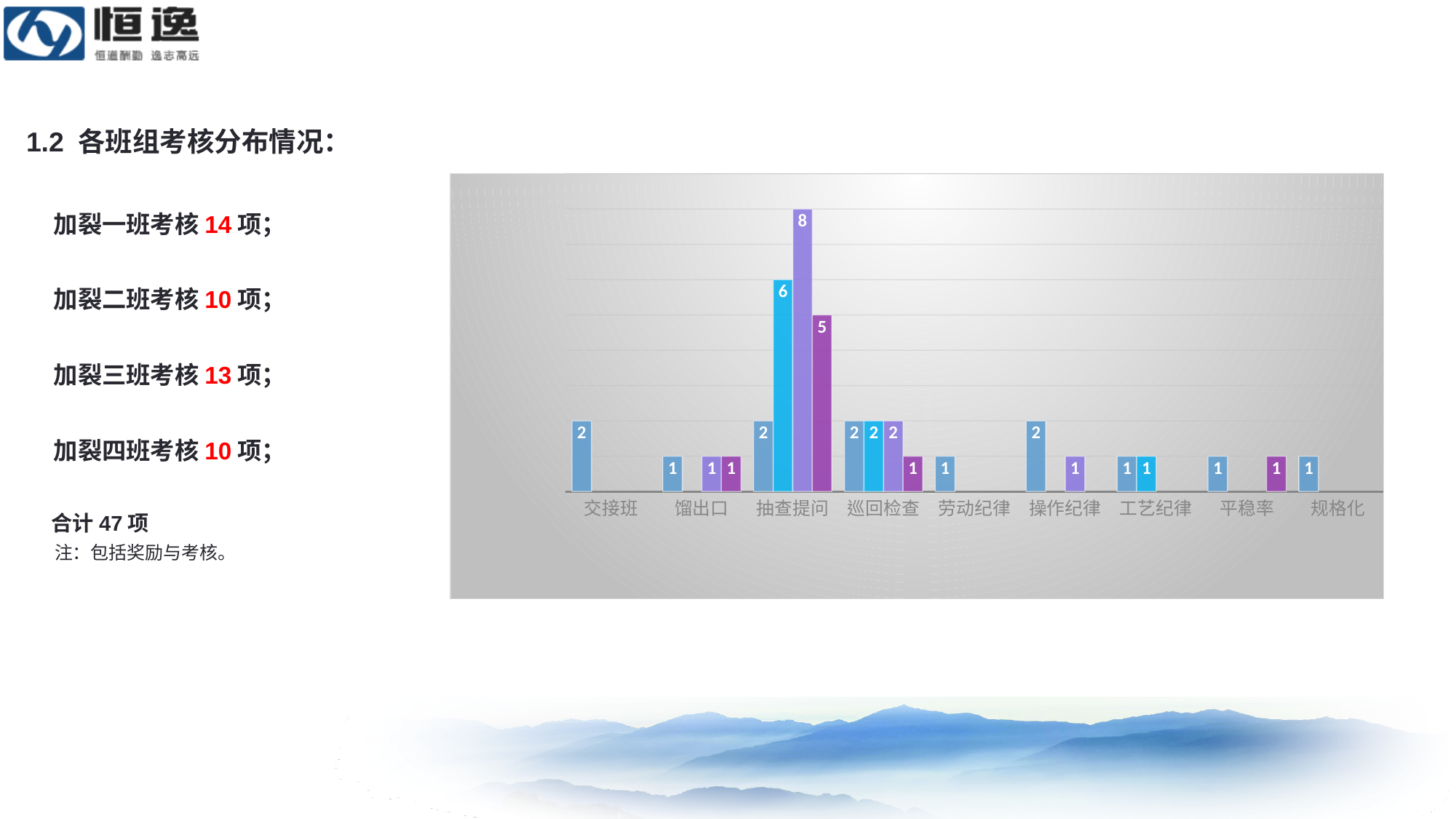
What is the total of all bars for 抽查提问? 21 What is the value of the bar for 劳动纪律? 1 What is the value of the tallest bar in the chart? 8 What is the value of the magenta bar for 抽查提问? 5 What is the value of the bar for 交接班? 2 What is the difference between the purple bar and the cyan bar for 抽查提问? 2 What kind of chart is shown on the slide? bar chart What is the value of the cyan bar for 抽查提问? 6 Which is larger: the magenta bar for 抽查提问 or the magenta bar for 巡回检查? 抽查提问 How many categories are shown along the x axis of the chart? 9 How many bars are shown for 巡回检查? 4 Which category has the tallest bar in the chart? 抽查提问